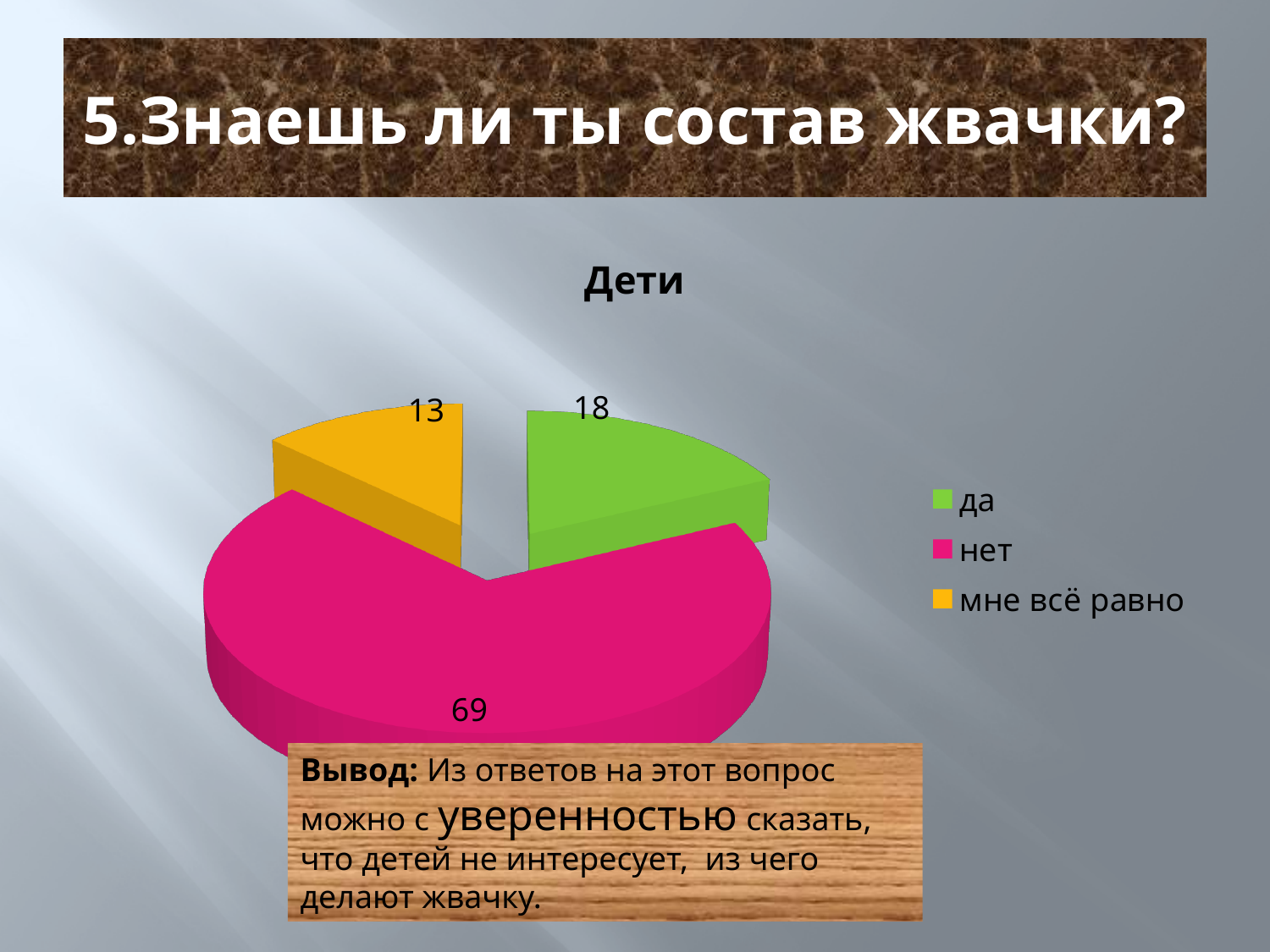
What share of the pie does the "нет" slice represent? 69% What is the value for "да"? 18 What type of chart is shown on the slide? pie chart Which category has the largest slice? нет Which category has the smallest slice? мне всё равно What is the title of the chart? Дети What is the value for "мне всё равно"? 13 What is the value for "нет"? 69 How many categories does the pie chart have? 3 What is the difference between the values for "нет" and "да"? 51 Which is larger, the value for "да" or the value for "мне всё равно"? да What colour is the "да" slice? green